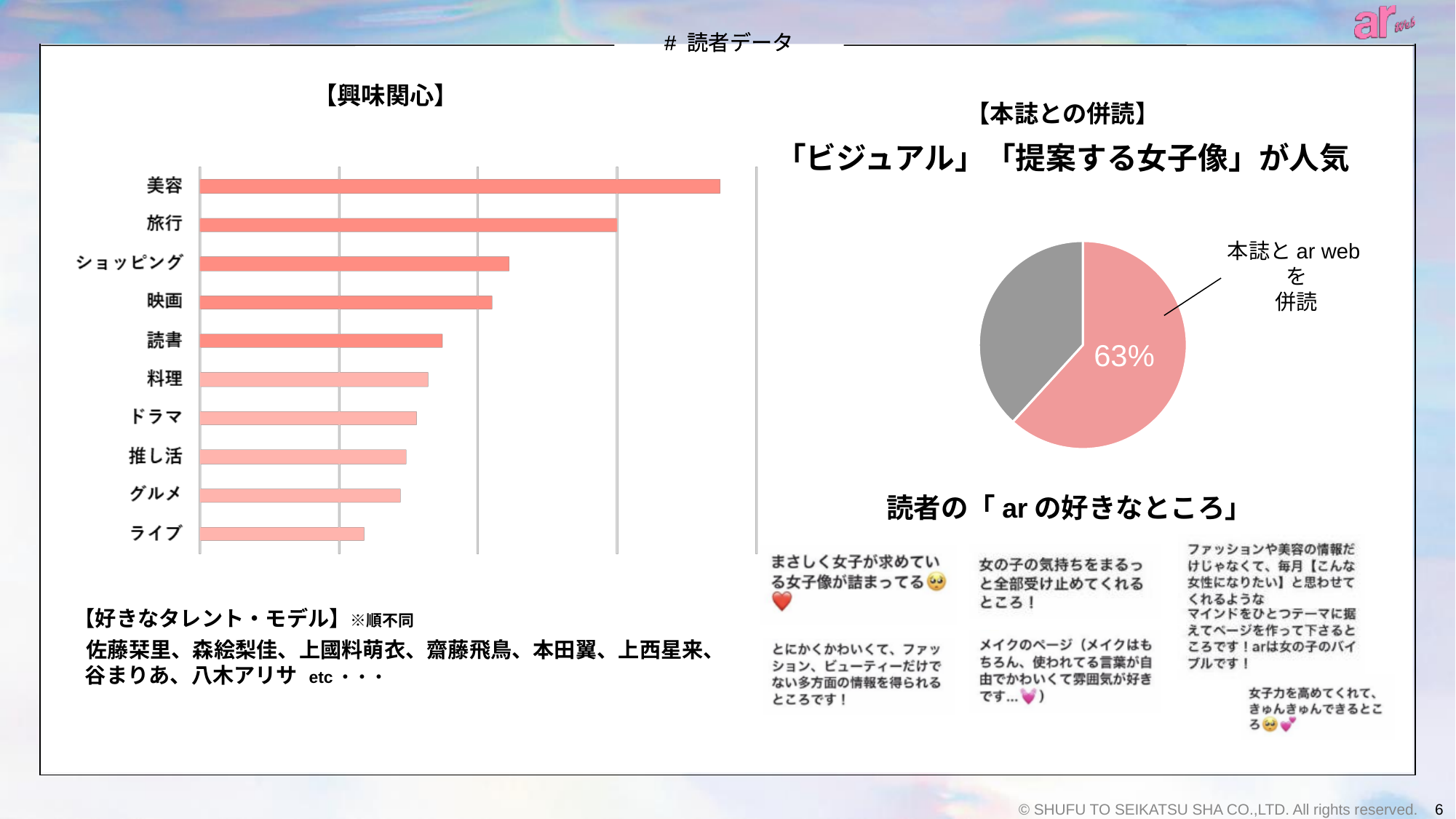
In the 【興味関心】 bar chart, which category has the longest bar? 美容 What is the title of the bar chart on the left of the slide? 【興味関心】 How many categories are shown in the 【興味関心】 bar chart? 10 In the 【興味関心】 bar chart, which is larger, 映画 or 料理? 映画 What kind of chart is the 【興味関心】 chart on the left? bar chart In the 【興味関心】 bar chart, do the bar lengths increase or decrease going from the top category to the bottom category? decrease In the 【興味関心】 bar chart, which is larger, 旅行 or ショッピング? 旅行 How many slices does the 【本誌との併読】 pie chart have? 2 What kind of chart is the 【本誌との併読】 chart on the right? pie chart In the 【本誌との併読】 pie chart, what colour is the slice labelled 63%? pink In the 【興味関心】 bar chart, which category has the shortest bar? ライブ In the 【本誌との併読】 pie chart, what share of readers read both 本誌 and ar web (本誌と ar web を併読)? 63%